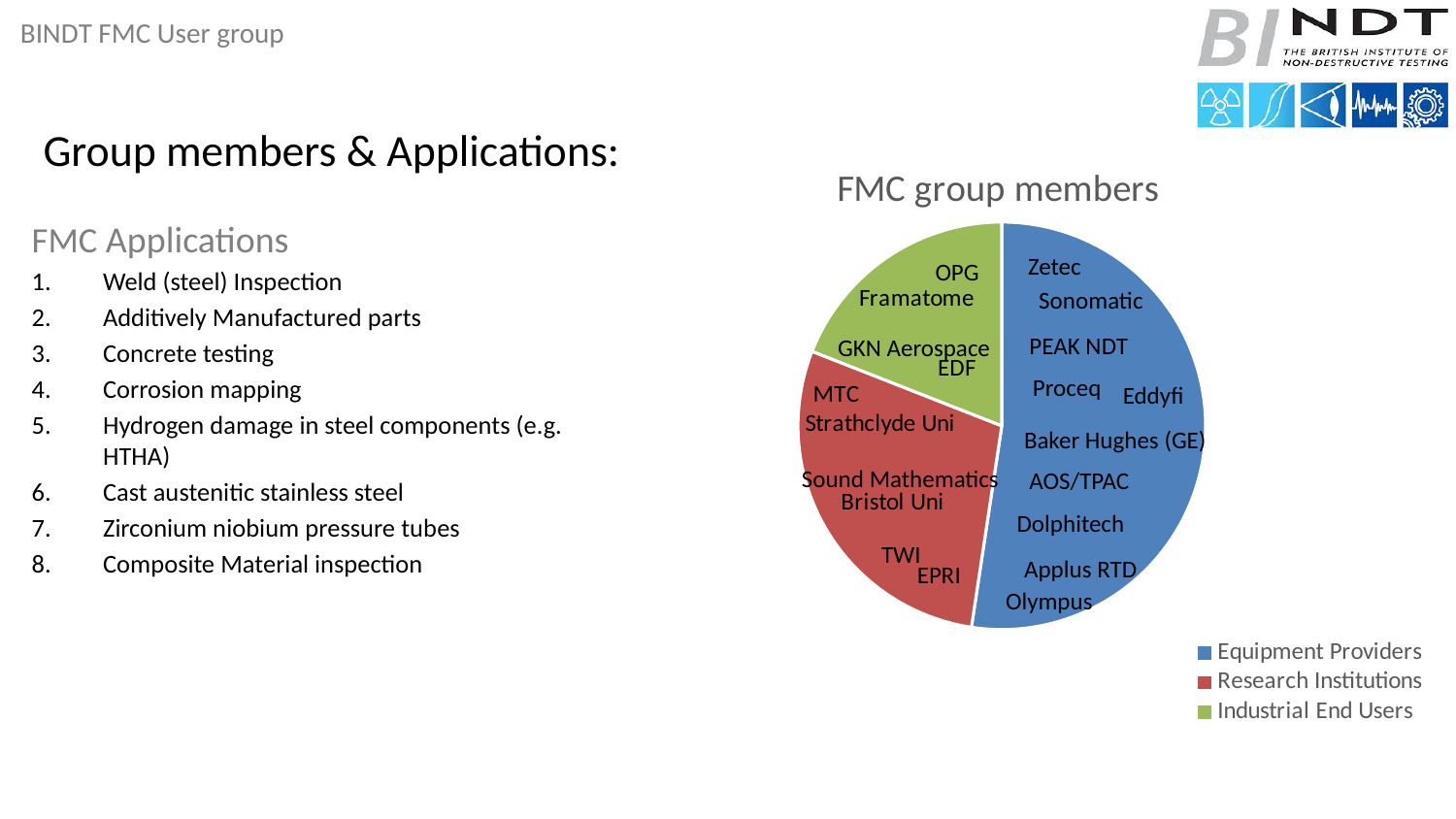
What kind of chart is shown on the slide? Pie chart What is the title of the pie chart? FMC group members What colour is the Equipment Providers slice in the pie chart? Blue How many slices does the pie chart have? 3 How many categories does the legend of the pie chart list? 3 Which category of the pie chart does Zetec belong to? Equipment Providers Which slice is larger, Research Institutions or Industrial End Users? Research Institutions Which category of the pie chart does TWI belong to? Research Institutions Which category of the pie chart does Framatome belong to? Industrial End Users Which category has the largest slice of the pie chart? Equipment Providers Which category has the smallest slice of the pie chart? Industrial End Users Which slice is larger, Equipment Providers or Research Institutions? Equipment Providers